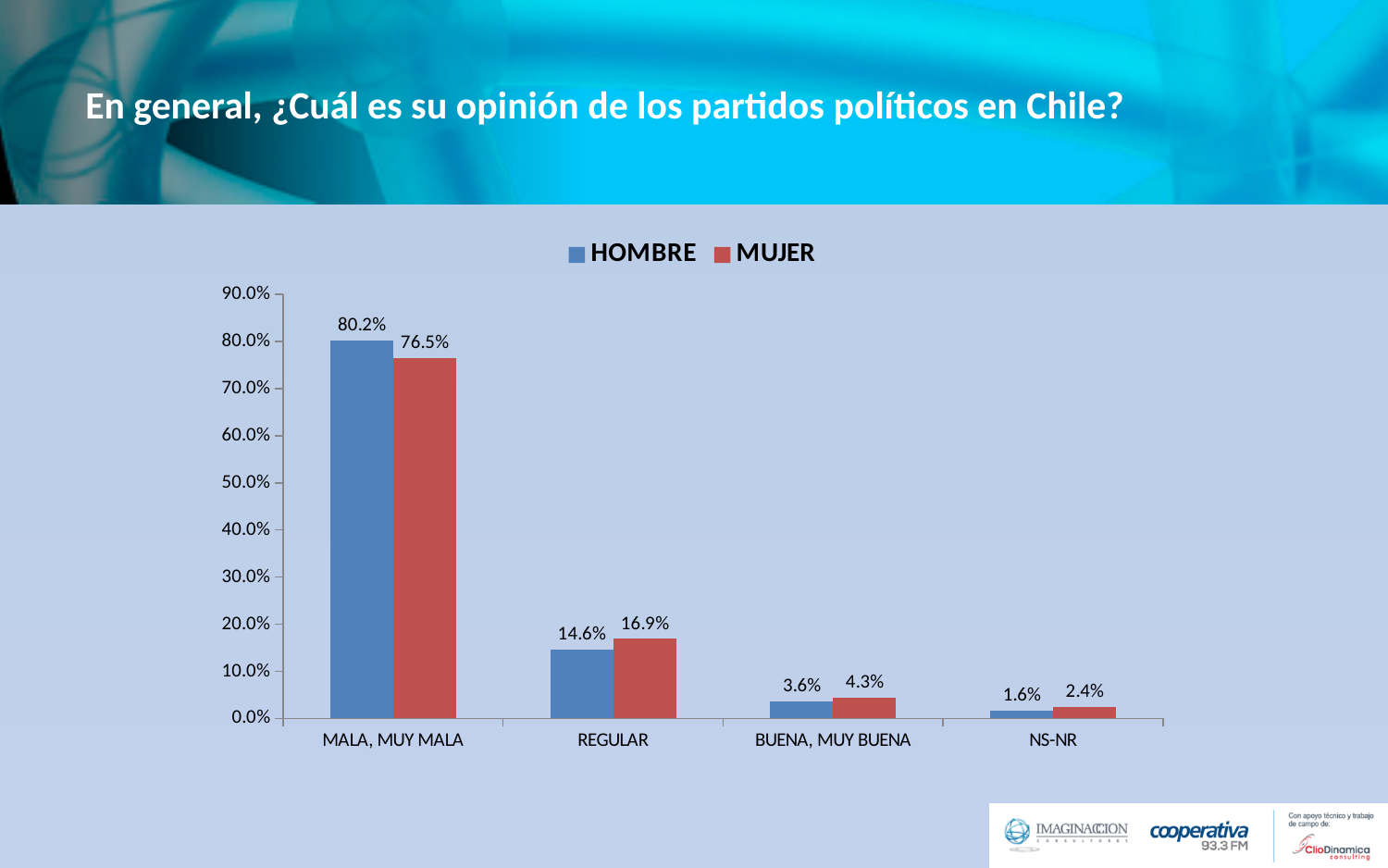
What is the HOMBRE value for MALA, MUY MALA? 80.2% What kind of chart is shown on the slide? bar chart What is the difference between the HOMBRE and MUJER values for MALA, MUY MALA? 3.7% What is the MUJER value for NS-NR? 2.4% Which category has the highest MUJER value? MALA, MUY MALA Which category has the lowest HOMBRE value? NS-NR How many categories are shown on the x axis? 4 How many series does the legend list? 2 Is the MUJER value for MALA, MUY MALA greater or less than 70.0%? greater What is the HOMBRE value for BUENA, MUY BUENA? 3.6% What is the MUJER value for REGULAR? 16.9% Which is larger for REGULAR, the HOMBRE value or the MUJER value? MUJER